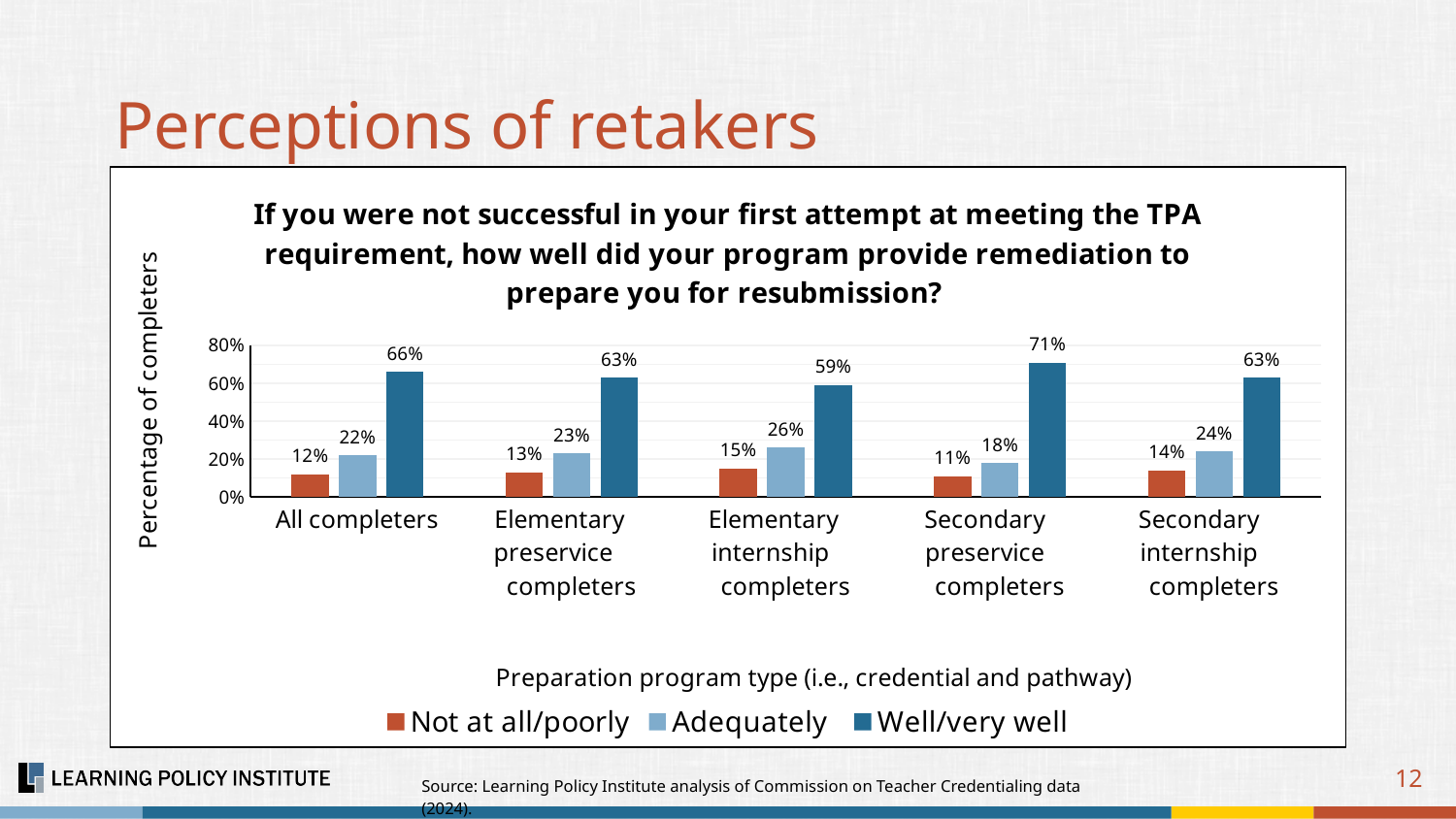
Which preparation program type has the lowest Well/very well percentage? Elementary internship completers Which is larger: the Adequately percentage for Elementary internship completers or for Secondary preservice completers? Elementary internship completers Which preparation program type has the highest Well/very well percentage? Secondary preservice completers What percentage of Secondary preservice completers answered Not at all/poorly? 11% What percentage of All completers answered Well/very well? 66% What is the difference between the Well/very well percentage for Secondary preservice completers and Elementary internship completers? 12% How many series does the legend list? 3 Which legend entry is shown in dark blue? Well/very well What kind of chart is shown on the slide? Bar chart How many preparation program types are shown on the x axis? 5 What percentage of Elementary internship completers answered Adequately? 26% What is the label of the y axis? Percentage of completers